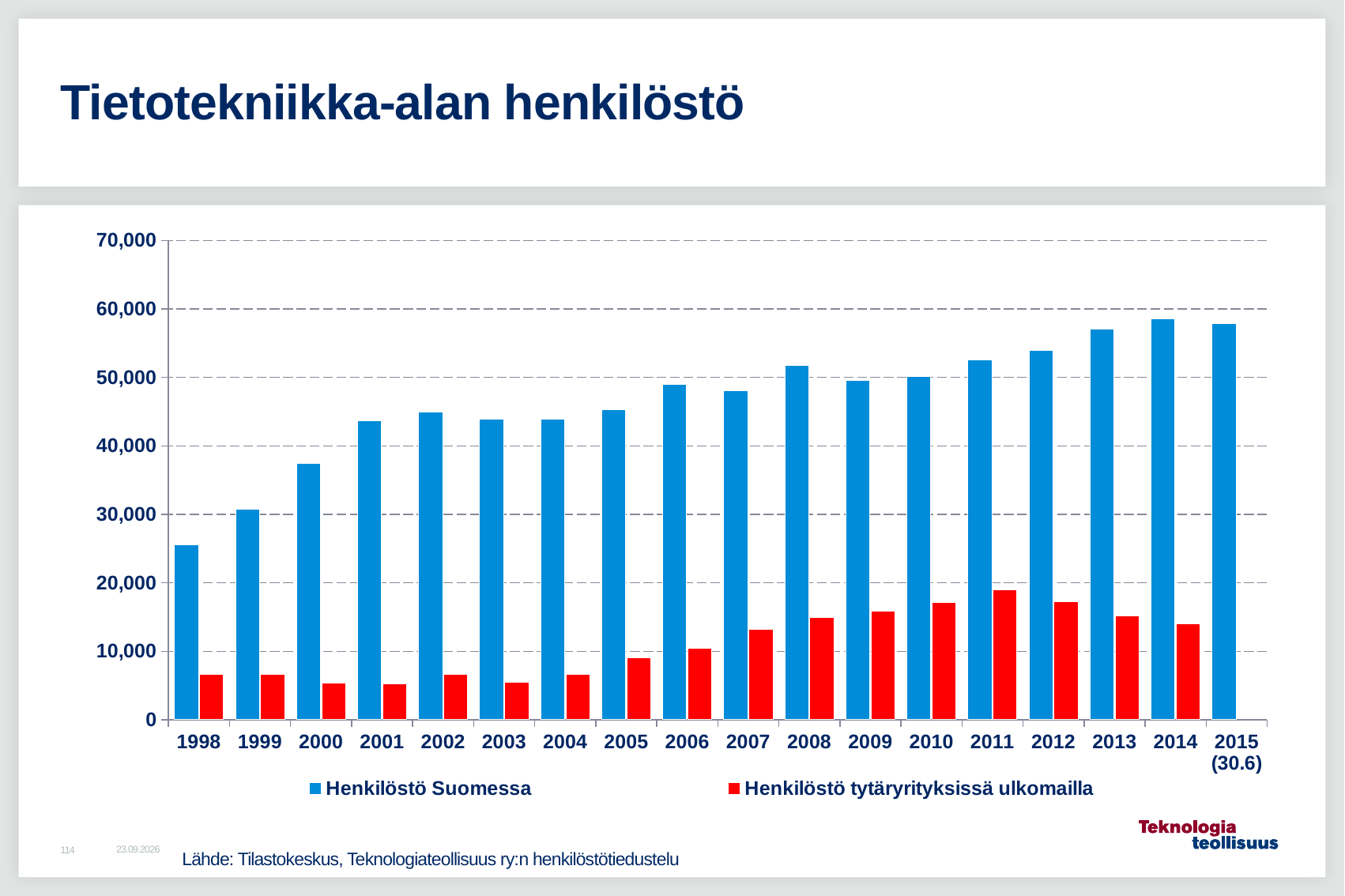
Which is larger, Henkilöstö Suomessa in 1999 or in 2001? 2001 What kind of chart is shown on the slide? bar chart How many series does the legend list? 2 Is the value for Henkilöstö Suomessa in 2013 greater or less than 50,000? greater Which year has the highest value for Henkilöstö tytäryrityksissä ulkomailla? 2011 Does the value for Henkilöstö Suomessa generally rise or fall from 1998 to 2014? rise Is the value for Henkilöstö Suomessa in 2000 greater or less than 40,000? less Which year has the highest value for Henkilöstö Suomessa? 2014 Which year has the lowest value for Henkilöstö Suomessa? 1998 What colour are the bars for Henkilöstö tytäryrityksissä ulkomailla? red How many year categories are shown on the x axis? 18